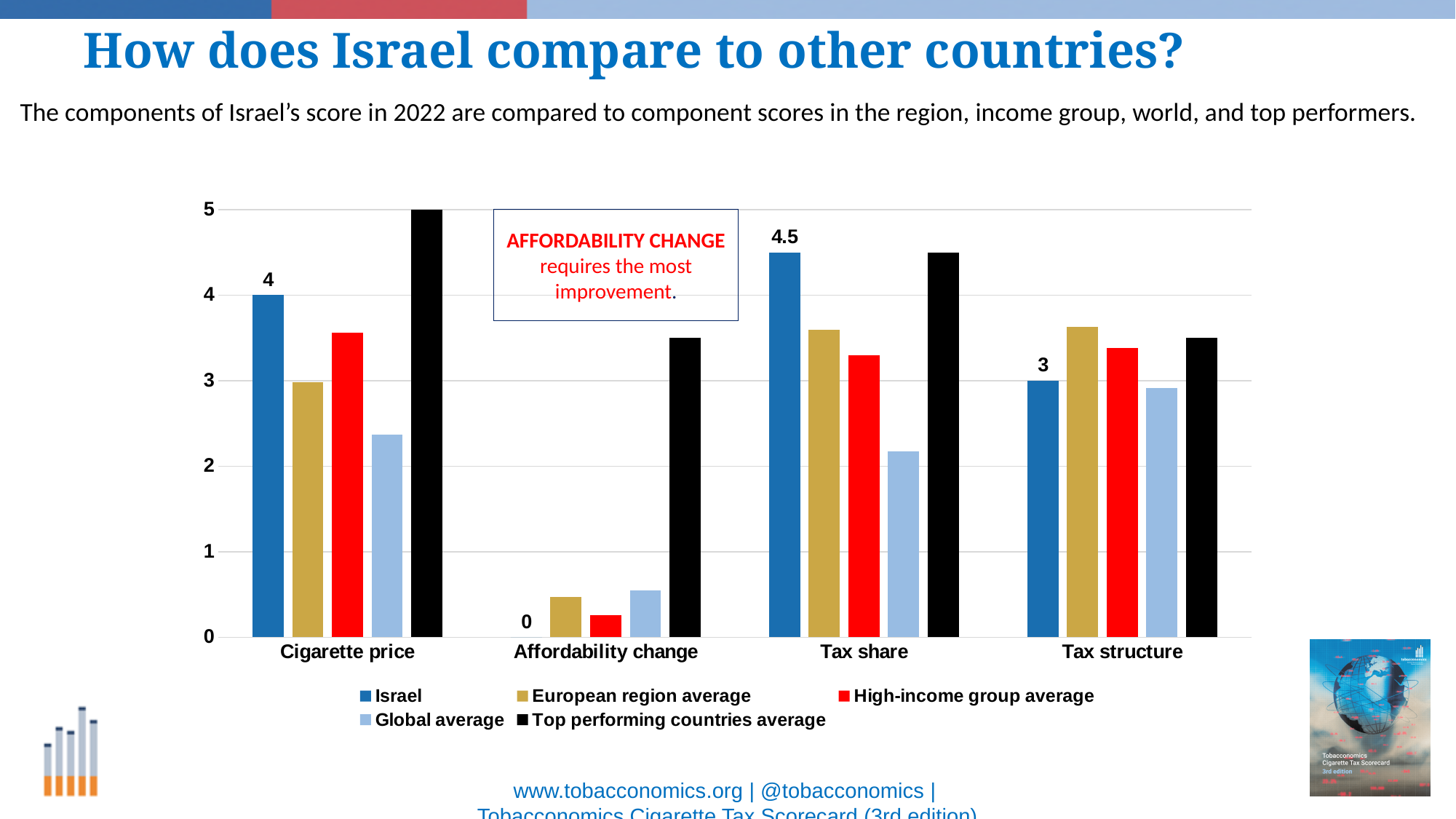
What is Israel's score for Tax share? 4.5 What kind of chart is shown on the slide? bar chart For Cigarette price, which is larger: Israel or Top performing countries average? Top performing countries average On which component does Israel score highest? Tax share What is the difference between Israel's Tax share score and its Cigarette price score? 0.5 Is the Global average value for Cigarette price greater or less than 3? less What is Israel's score for Affordability change? 0 What is Israel's score for Cigarette price? 4 On which component does Israel score lowest? Affordability change How many components are shown on the x axis? 4 How many series does the legend list? 5 What is Israel's score for Tax structure? 3